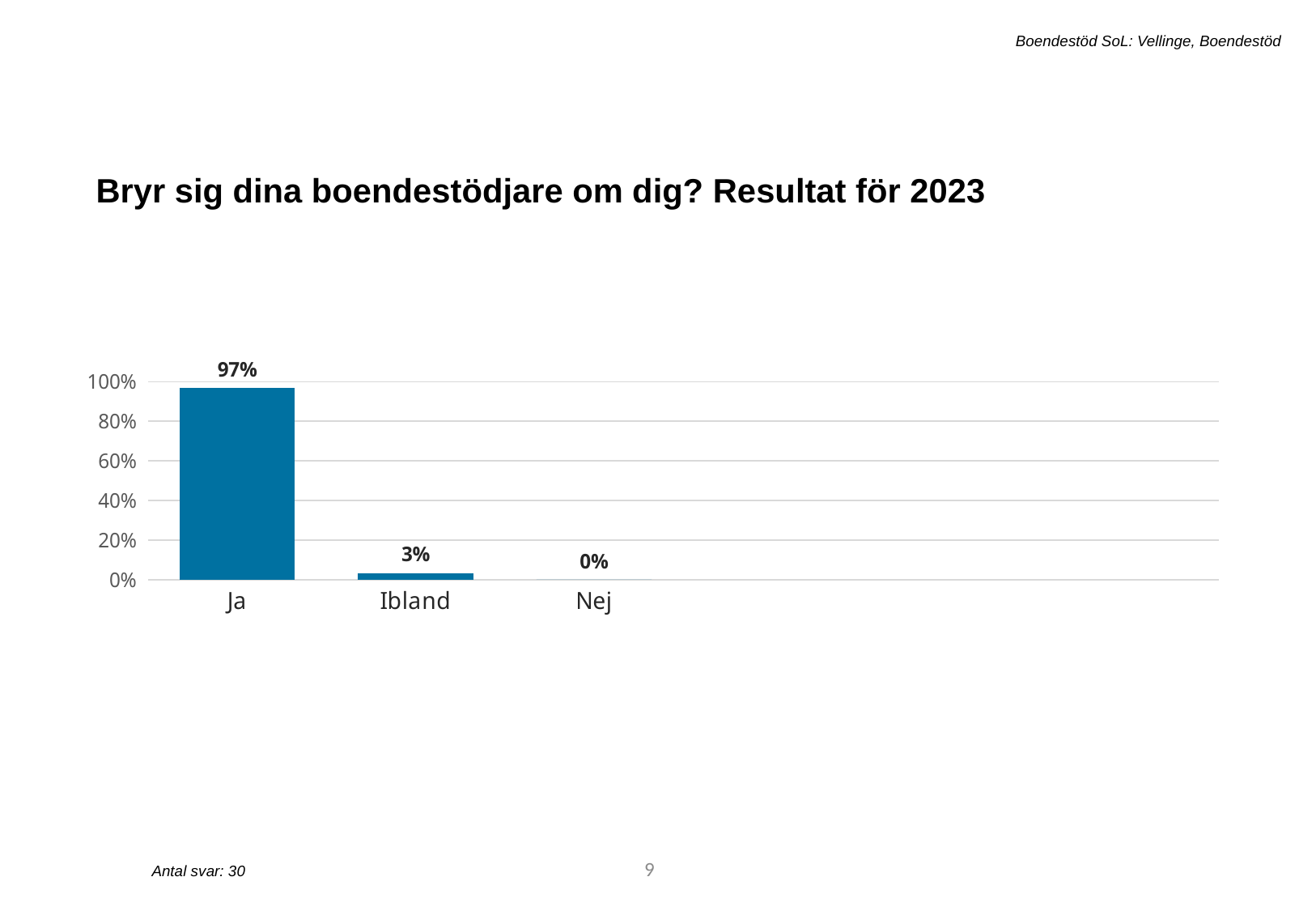
What is the difference between the values for Ja and Ibland? 94% What is the value for Nej? 0% How many categories are shown on the x axis? 3 Which is larger, the value for Ibland or the value for Nej? Ibland Which category has the highest value? Ja Do the values rise or fall from left to right along the x axis? fall What kind of chart is shown on the slide? bar chart What is the value for Ja? 97% What is the value for Ibland? 3% Which category has the lowest value? Nej What is the title of the chart on the slide? Bryr sig dina boendestödjare om dig? Resultat för 2023 Is the value for Ja greater or less than 80%? greater